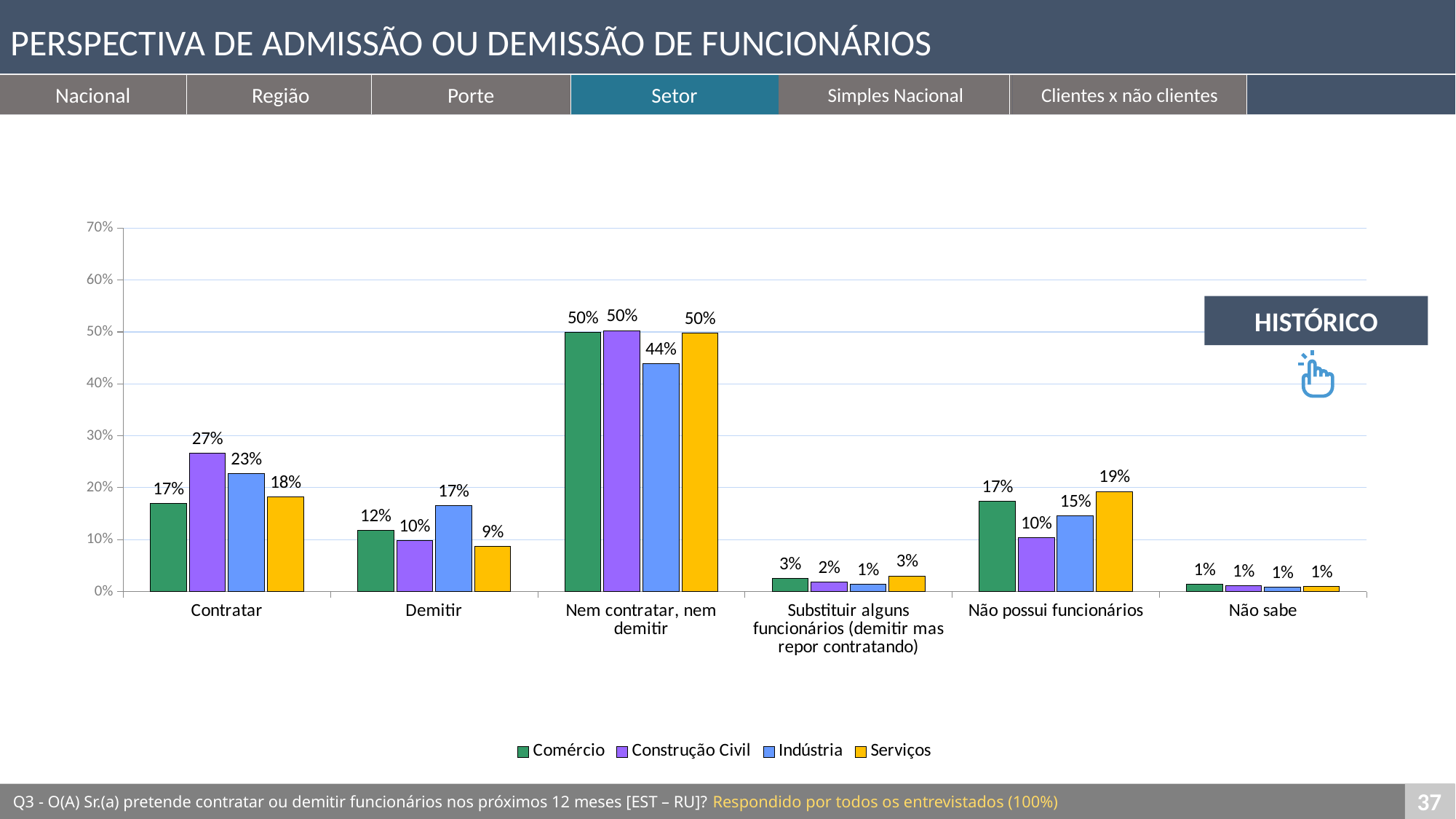
What is the value for Construção Civil in the Contratar category? 27% How many series does the legend list? 4 Which tab is highlighted in the navigation bar at the top of the slide? Setor Which series has the highest value in the Demitir category? Indústria What is the value for Indústria in the Nem contratar, nem demitir category? 44% What kind of chart is shown on the slide? Bar chart Which series has the lowest value in the Substituir alguns funcionários (demitir mas repor contratando) category? Indústria What is the difference between Construção Civil and Comércio in the Contratar category? 10% Which category has the highest values across all series? Nem contratar, nem demitir Which is larger in the Não possui funcionários category: Comércio or Construção Civil? Comércio What is the value for Serviços in the Não possui funcionários category? 19% How many categories are shown on the x axis? 6